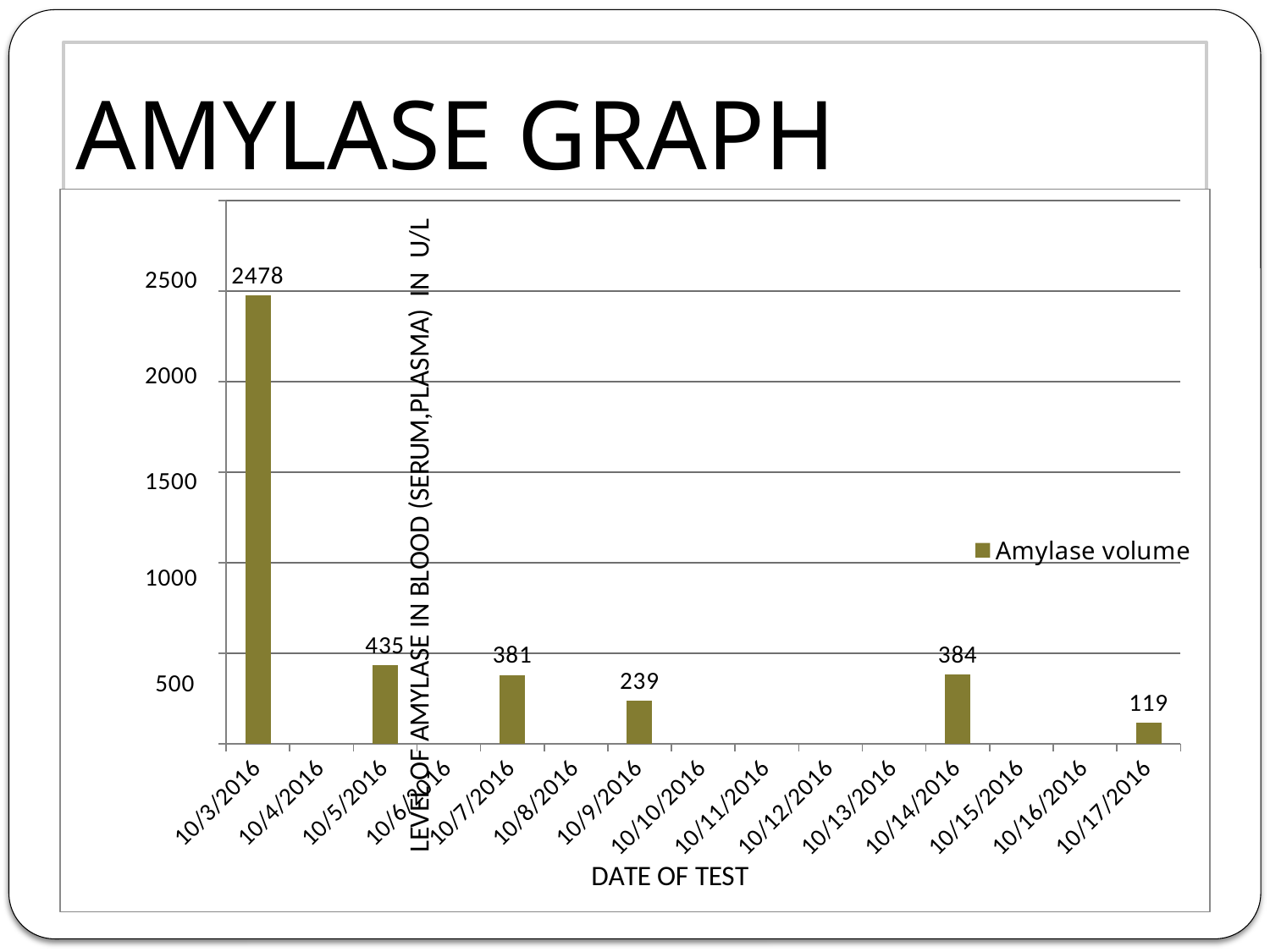
How many series does the legend list? 1 What is the Amylase volume on 10/9/2016? 239 What is the difference between the Amylase volume on 10/14/2016 and on 10/17/2016? 265 On which date is the Amylase volume highest? 10/3/2016 What is the Amylase volume on 10/17/2016? 119 What is the Amylase volume on 10/3/2016? 2478 What is the Amylase volume on 10/5/2016? 435 On which date is the Amylase volume lowest? 10/17/2016 What is the difference between the Amylase volume on 10/3/2016 and on 10/5/2016? 2043 Which date has a larger Amylase volume, 10/7/2016 or 10/9/2016? 10/7/2016 What kind of chart is shown on the slide? Bar chart What is the title of the x axis? DATE OF TEST